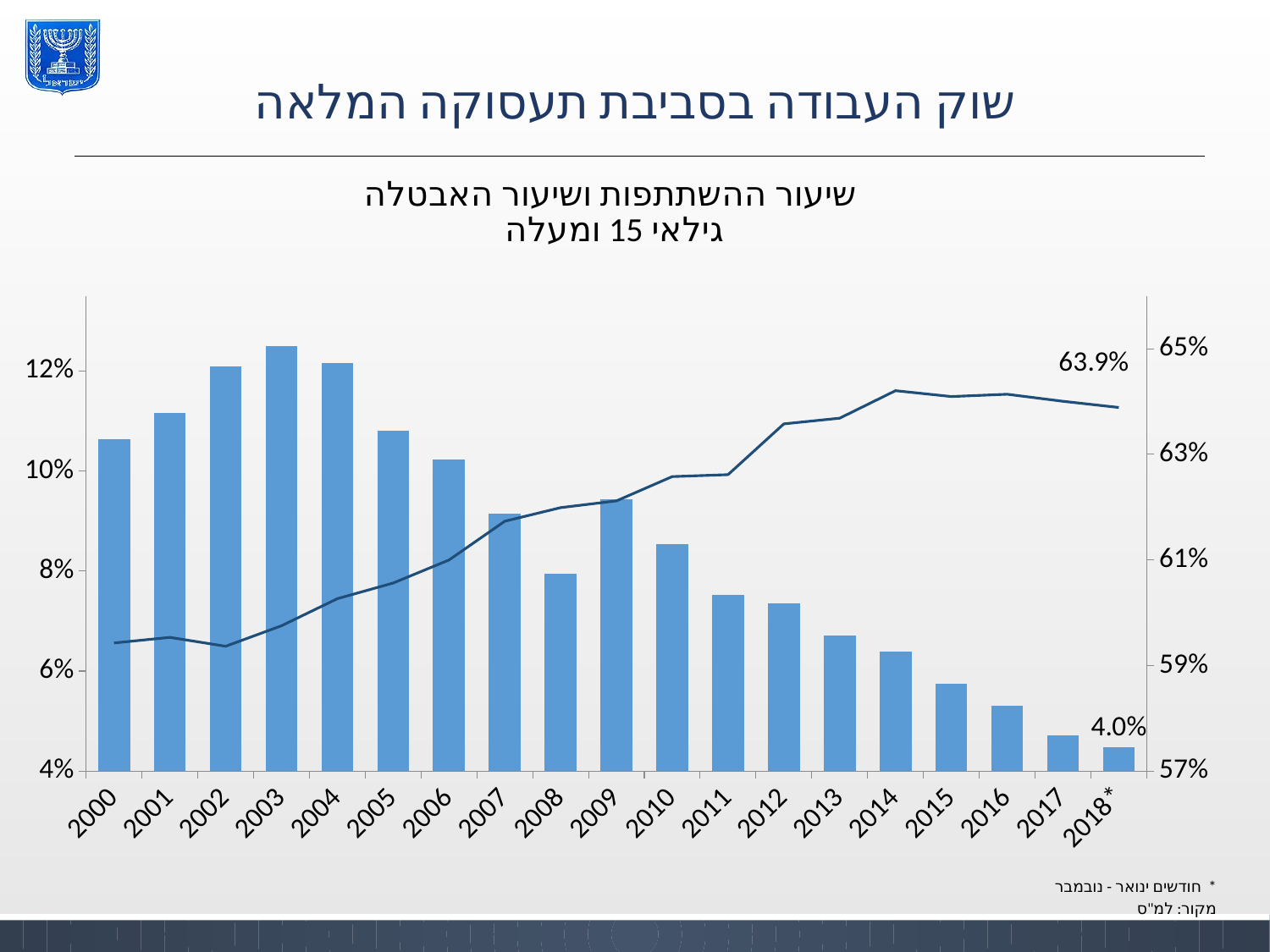
Is the bar value for 2000 greater or less than 10%? greater What kind of chart is this? A combined bar and line chart Does the line rise or fall from 2000 to 2014? Rise What is the title of the chart? שיעור ההשתתפות ושיעור האבטלה גילאי 15 ומעלה Which year has the taller bar, 2009 or 2010? 2009 What is the data label shown on the bar for 2018*? 4.0% What is the data label shown on the line for 2018*? 63.9% How many years are shown on the x axis? 19 Is the line value for 2000 greater or less than 61%? less Which year has the tallest bar? 2003 Which year has the shortest bar? 2018* Do the bar values rise or fall from 2003 to 2018*? Fall